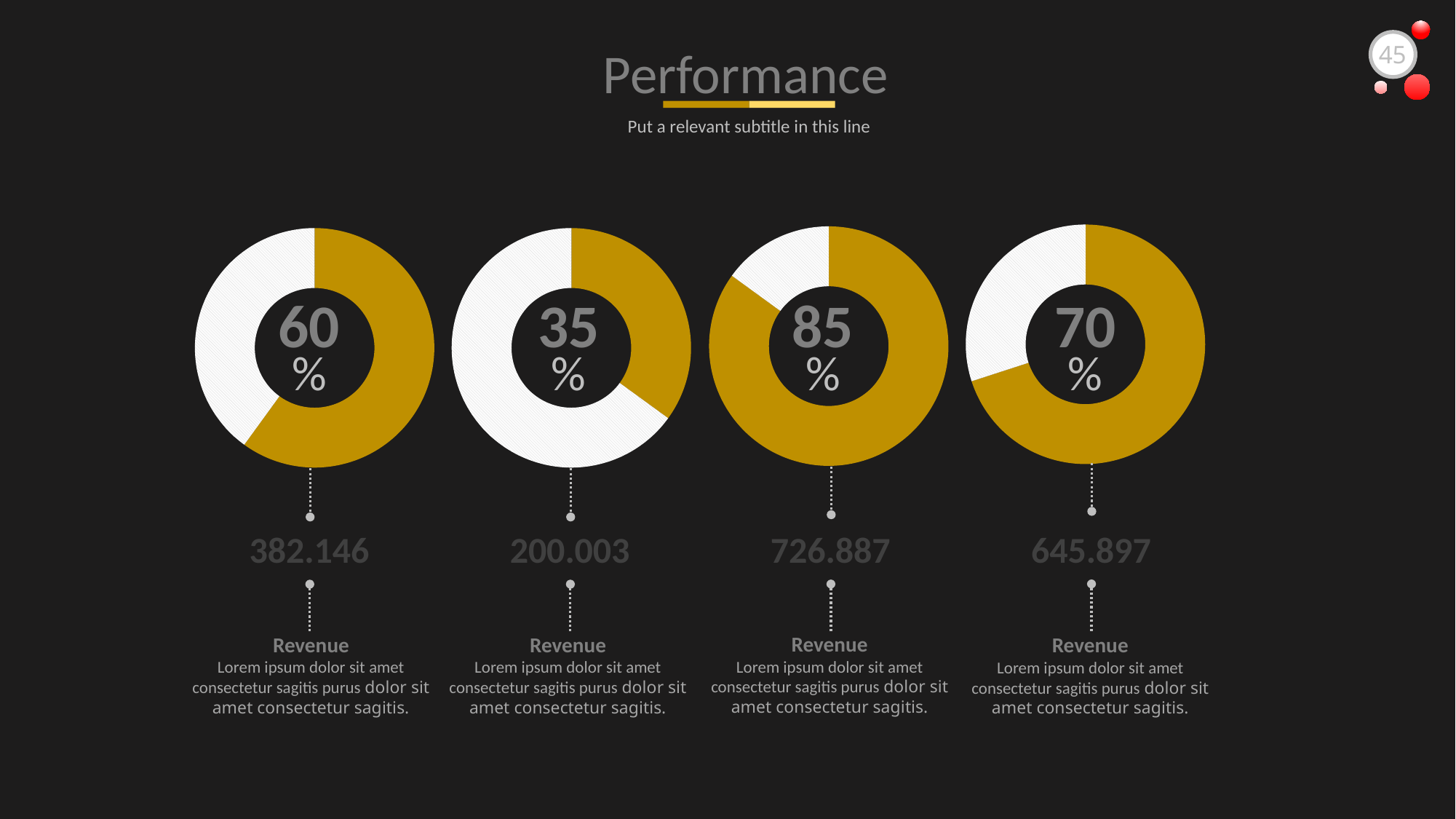
What percentage is shown in the centre of the third donut chart from the left? 85% What percentage is shown in the centre of the second donut chart from the left? 35% What value is printed below the leftmost donut chart? 382.146 What percentage is shown in the centre of the rightmost donut chart? 70% Which donut chart shows the lowest percentage? The second from the left (35%) What percentage is shown in the centre of the leftmost donut chart? 60% Which donut chart shows the highest percentage? The third from the left (85%) Which is larger: the percentage in the leftmost donut chart or the percentage in the rightmost donut chart? The rightmost (70%) What is the difference between the percentage in the third donut chart and the percentage in the second donut chart? 50% What kind of chart is used to show the percentages on this slide? Donut chart How many donut charts are on the slide? 4 What value is printed below the third donut chart from the left? 726.887